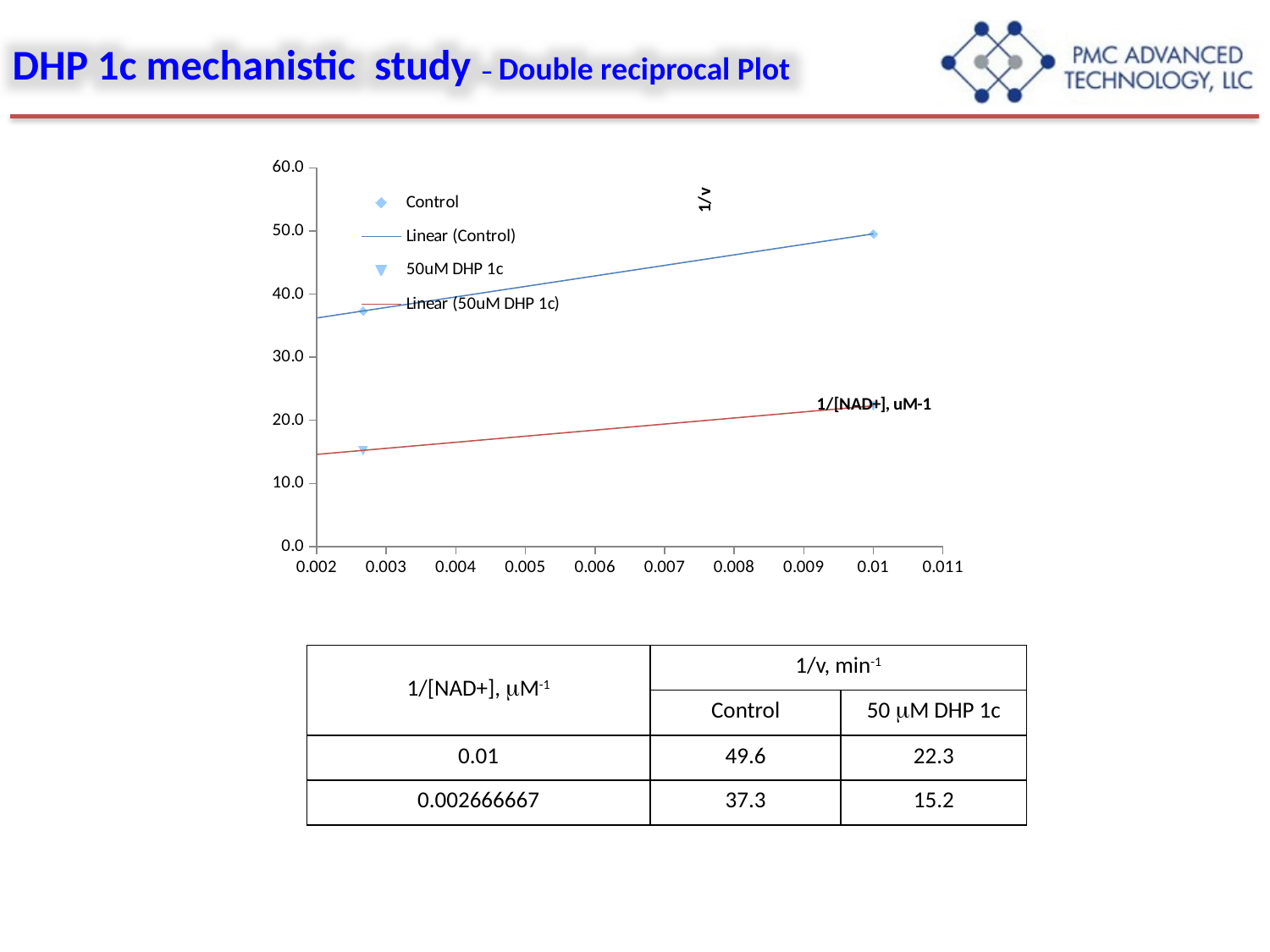
What is the difference between the Control 1/v values at 1/[NAD+] = 0.01 and 0.002666667? 12.3 What is the 1/v value for 50 µM DHP 1c at 1/[NAD+] = 0.01? 22.3 What is the 1/v value for Control at 1/[NAD+] = 0.002666667? 37.3 How many entries does the chart legend list? 4 How many data points are plotted for the 50uM DHP 1c series? 2 Which series has the higher 1/v value at 1/[NAD+] = 0.01, Control or 50 µM DHP 1c? Control What is the 1/v value for Control at 1/[NAD+] = 0.01? 49.6 Do the 1/v values for the Control series rise or fall as 1/[NAD+] increases? rise Is the Control 1/v value at 1/[NAD+] = 0.01 greater or less than 40.0? greater What is the difference between the Control and 50 µM DHP 1c 1/v values at 1/[NAD+] = 0.01? 27.3 What kind of chart is shown on the slide? scatter chart What is the 1/v value for 50 µM DHP 1c at 1/[NAD+] = 0.002666667? 15.2